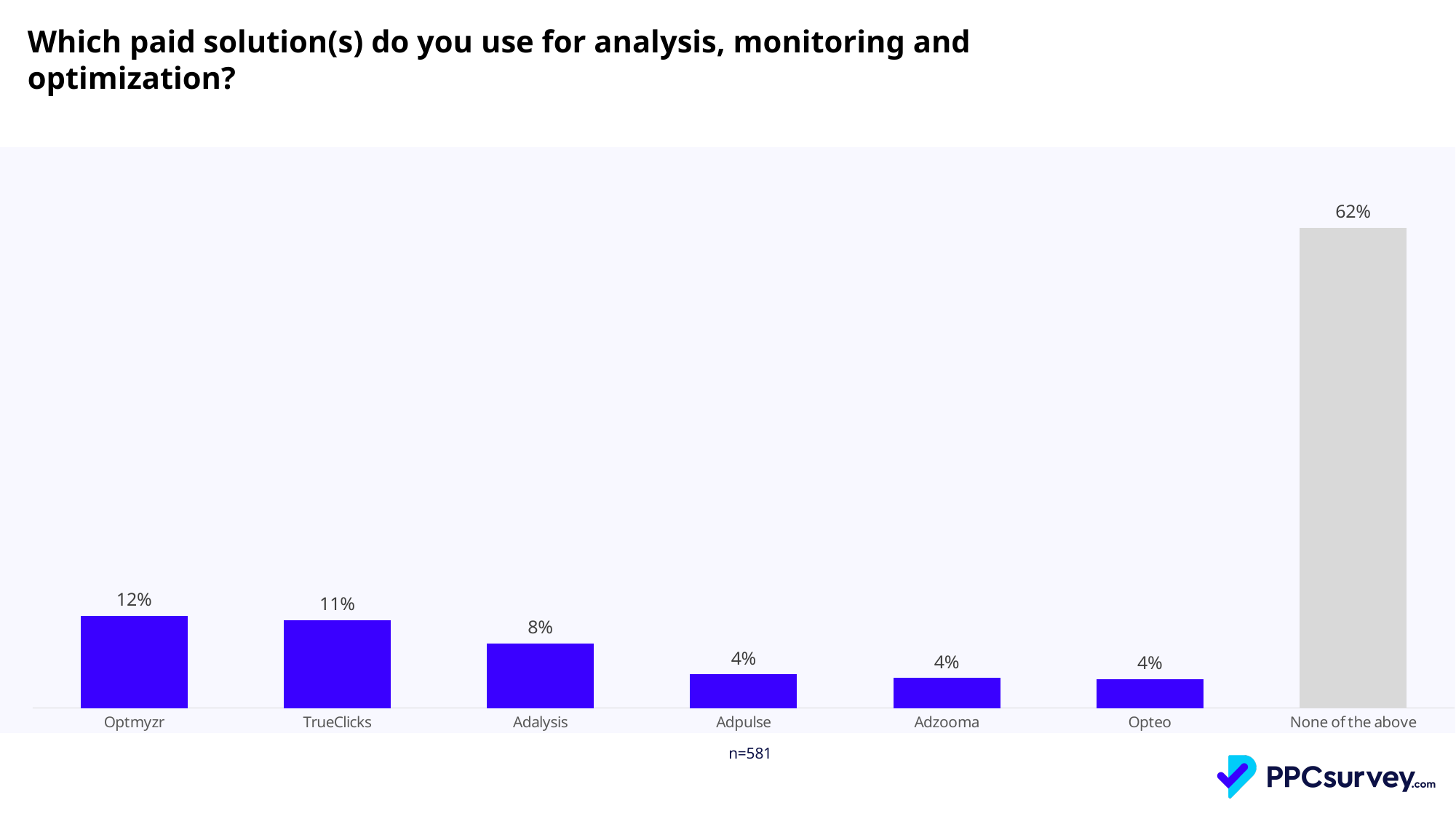
What is the difference between the values for Optmyzr and Adalysis? 4% What is the difference between 'None of the above' and Optmyzr? 50% What percentage of respondents use Adalysis? 8% How many categories are shown on the chart? 7 What percentage of respondents selected 'None of the above'? 62% Which category has the highest value? None of the above What is the sample size (n) shown below the chart? n=581 What kind of chart is shown on the slide? Bar chart Among the named paid solutions (excluding 'None of the above'), which has the highest value? Optmyzr What percentage of respondents use Optmyzr? 12% What percentage of respondents use TrueClicks? 11% Which is larger, the value for TrueClicks or the value for Adpulse? TrueClicks